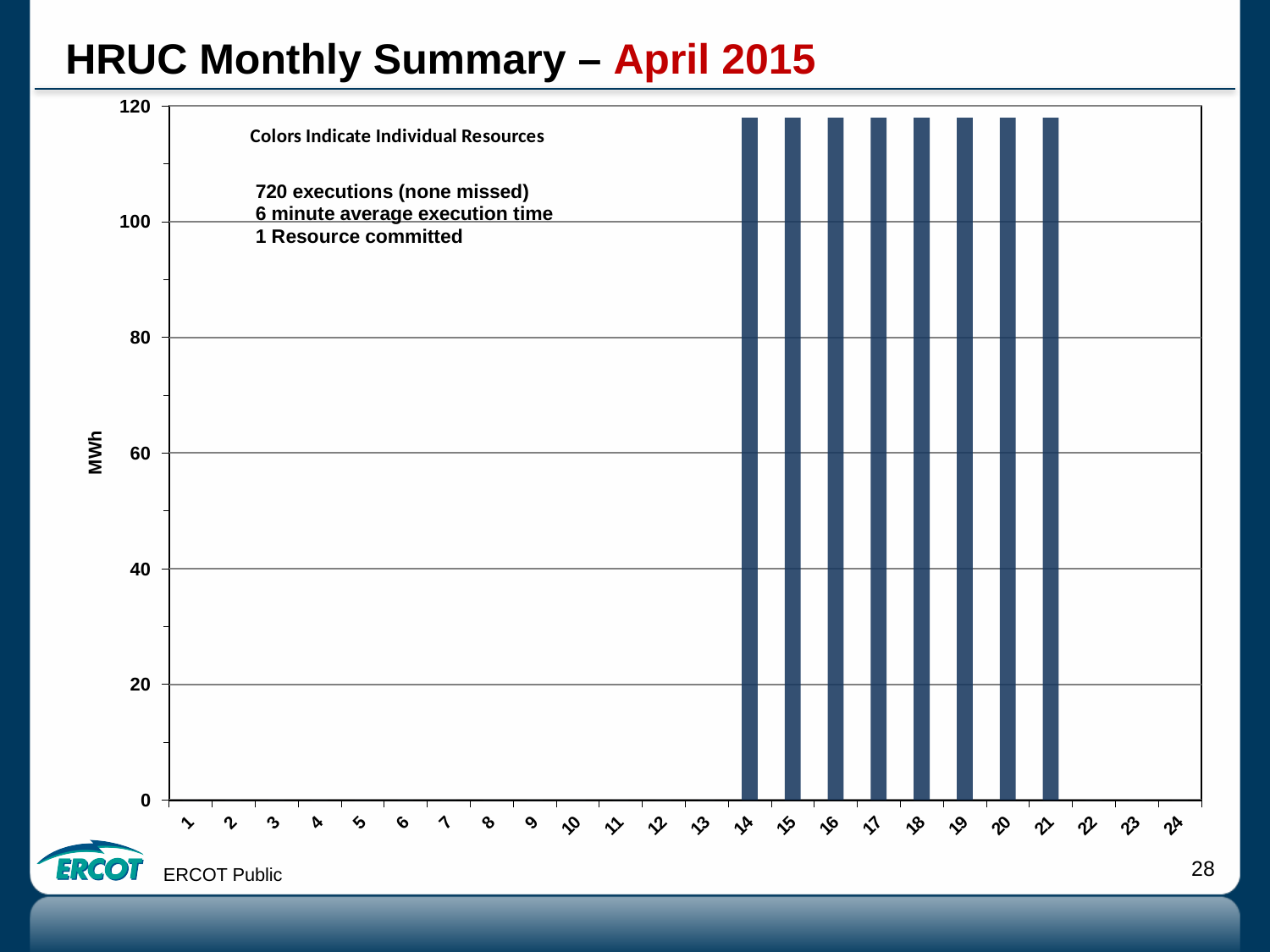
What is the highest tick value shown on the y axis? 120 Is the value for category 14 greater or less than 100? greater Which has the larger value, category 14 or category 5? 14 How many categories are shown along the x axis of the chart? 24 What is the label on the y axis of the chart? MWh Is the value for category 18 greater or less than 80? greater Which x-axis categories have non-zero bars? 14 through 21 How many categories on the x axis have a visible bar (a non-zero value)? 8 Is the value for category 10 greater or less than 20? less Which has the larger value, category 23 or category 21? 21 What kind of chart is shown on the slide? Bar chart